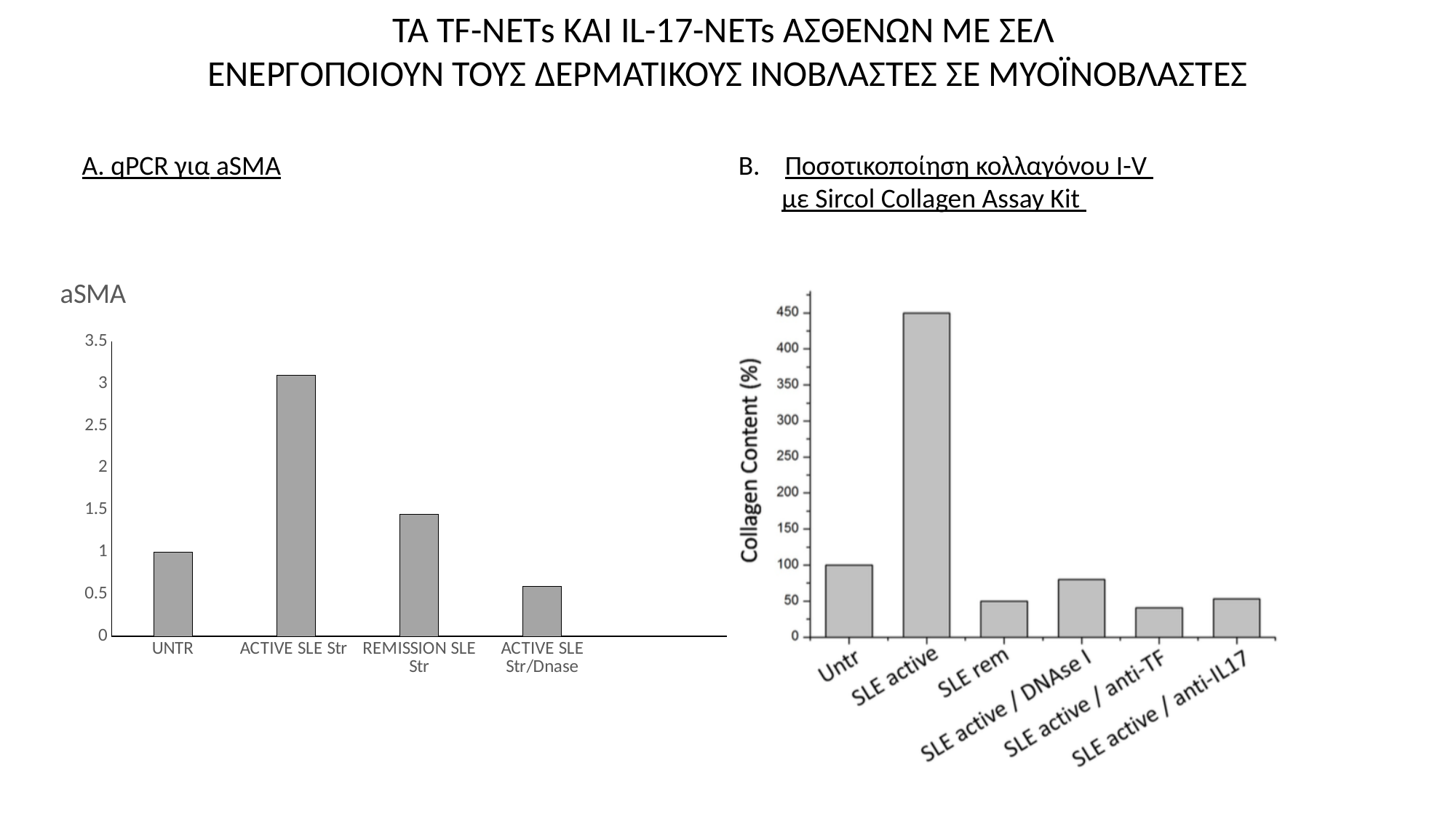
In the Collagen Content chart on the right, what is the value for SLE active? 450 In the aSMA chart on the left, which category has the highest value? ACTIVE SLE Str In the aSMA chart on the left, is the value for ACTIVE SLE Str greater or less than 3? greater What is the y-axis label of the chart on the right? Collagen Content (%) In the aSMA chart on the left, which category has the lowest value? ACTIVE SLE Str/Dnase In the Collagen Content chart on the right, which category has the highest value? SLE active In the Collagen Content chart on the right, is the value for SLE active / anti-TF greater or less than 50? less How many categories does the Collagen Content chart on the right show? 6 What kind of chart is the aSMA chart on the left? bar chart In the aSMA chart on the left, which is larger, the value for UNTR or the value for ACTIVE SLE Str/Dnase? UNTR In the aSMA chart on the left, is the value for REMISSION SLE Str greater or less than 1? greater How many categories does the aSMA chart on the left show? 4